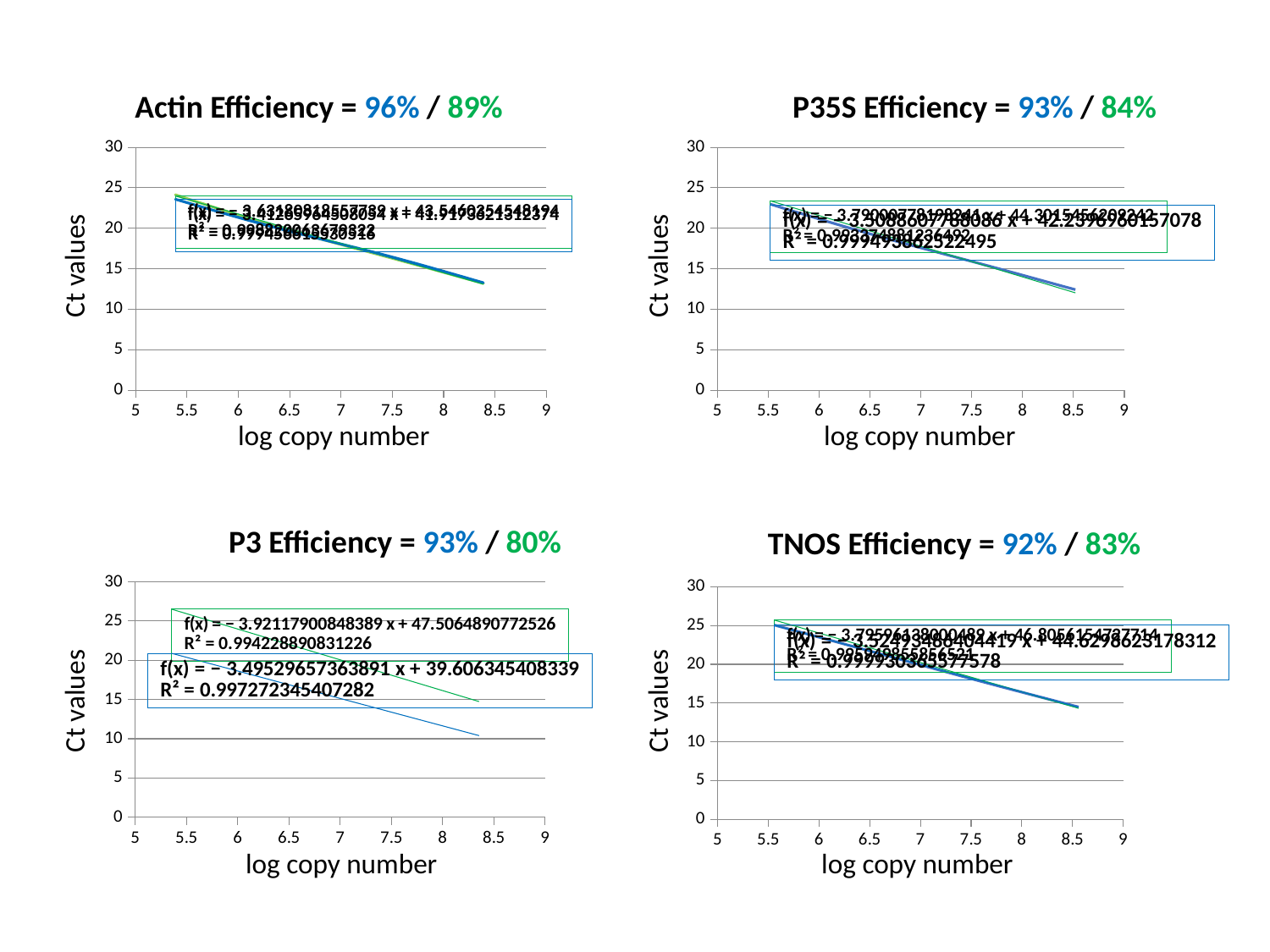
In the P3 Efficiency chart, what is the slope in the equation f(x) = -3.49529657363891 x + 39.606345408339 shown in the lower box? -3.49529657363891 In the P3 Efficiency chart, is the Ct value at the right end of the blue line (around log copy number 8.4) greater or less than 15? less In the P3 Efficiency chart, what R² value is shown in the upper equation box? 0.994228890831226 In the P35S Efficiency chart, is the Ct value at the left end of the lines (around log copy number 5.5) greater or less than 20? greater What kind of chart is the Actin Efficiency chart? line chart In the Actin Efficiency chart, do the Ct values rise or fall as log copy number increases? fall In the P35S Efficiency chart, do the Ct values rise or fall along the x axis? fall How many charts are shown on the slide? 4 In the Actin Efficiency chart, is the Ct value at the right end of the lines (around log copy number 8.4) greater or less than 15? less What is the y-axis label on the TNOS Efficiency chart? Ct values What is the title of the top-left chart? Actin Efficiency = 96% / 89%